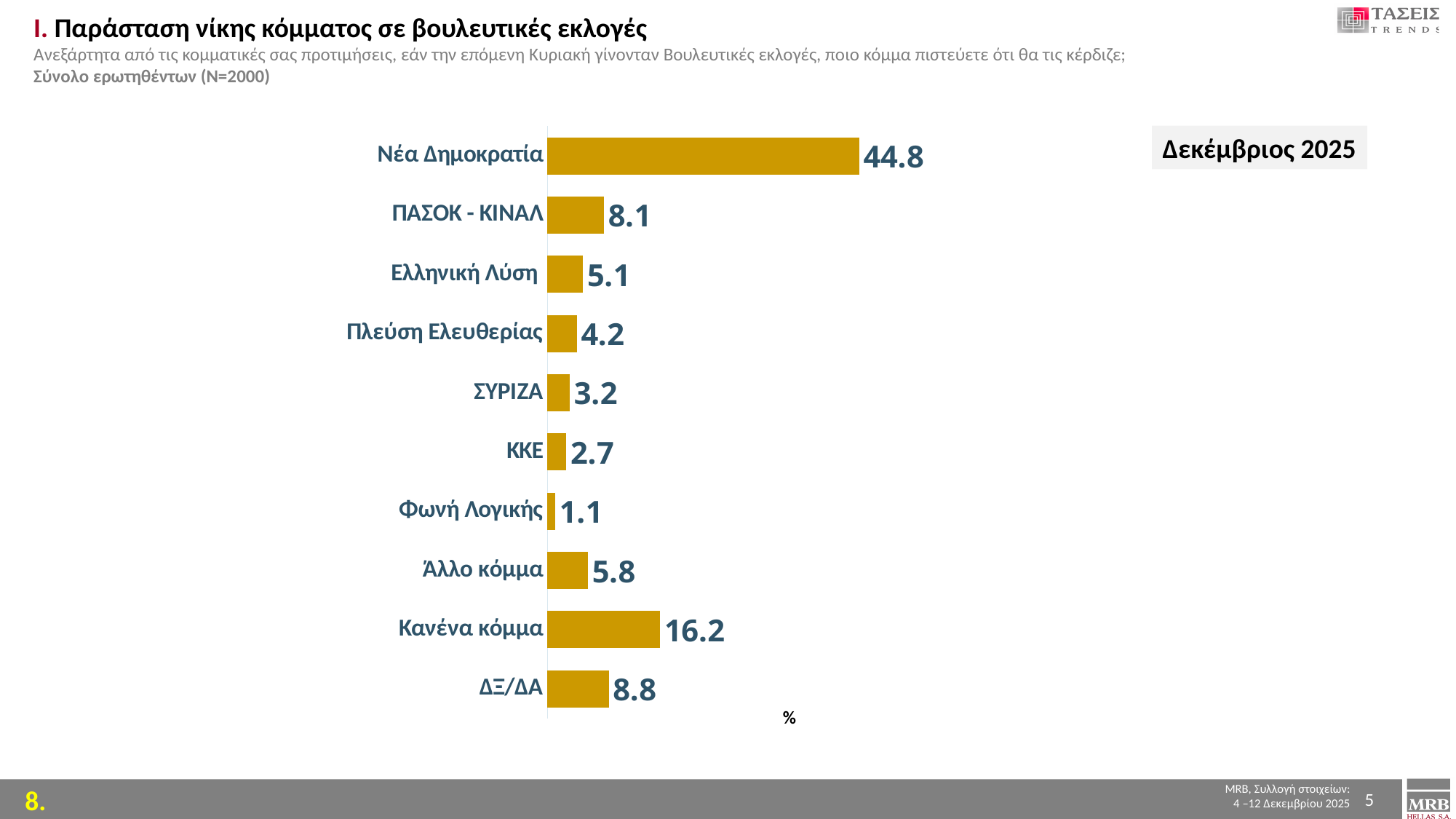
What is the difference between the values for ΠΑΣΟΚ - ΚΙΝΑΛ and Ελληνική Λύση? 3.0 What is the value for Νέα Δημοκρατία? 44.8 Which category has the lowest value? Φωνή Λογικής How many categories are shown in the chart? 10 What is the value for Κανένα κόμμα? 16.2 What kind of chart is shown on the slide? Bar chart What is the difference between the values for Νέα Δημοκρατία and Κανένα κόμμα? 28.6 What month and year is shown in the box next to the chart? Δεκέμβριος 2025 What is the value for ΔΞ/ΔΑ? 8.8 What is the value for ΣΥΡΙΖΑ? 3.2 Which category has the highest value? Νέα Δημοκρατία Which is larger, the value for ΔΞ/ΔΑ or the value for ΠΑΣΟΚ - ΚΙΝΑΛ? ΔΞ/ΔΑ